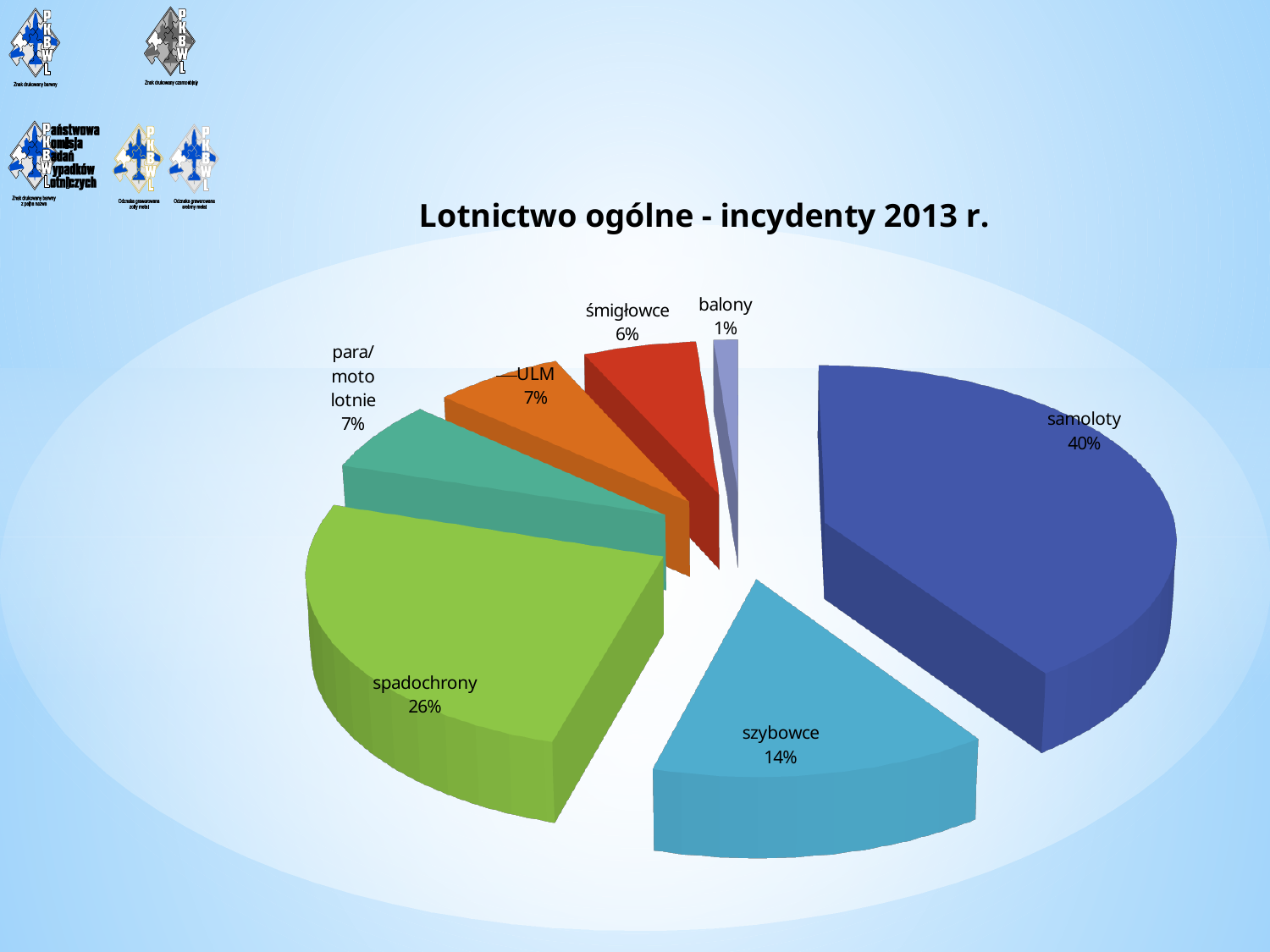
What share of the pie does śmigłowce have? 6% What share of the pie does balony have? 1% How many categories are shown in the pie chart? 7 Which is larger, szybowce or ULM? szybowce What share of the pie does szybowce have? 14% What kind of chart is shown on the slide? pie chart Which category has the smallest slice of the pie? balony What is the title of the chart? Lotnictwo ogólne - incydenty 2013 r. Which category has the largest slice of the pie? samoloty What is the difference in percentage points between samoloty and spadochrony? 14